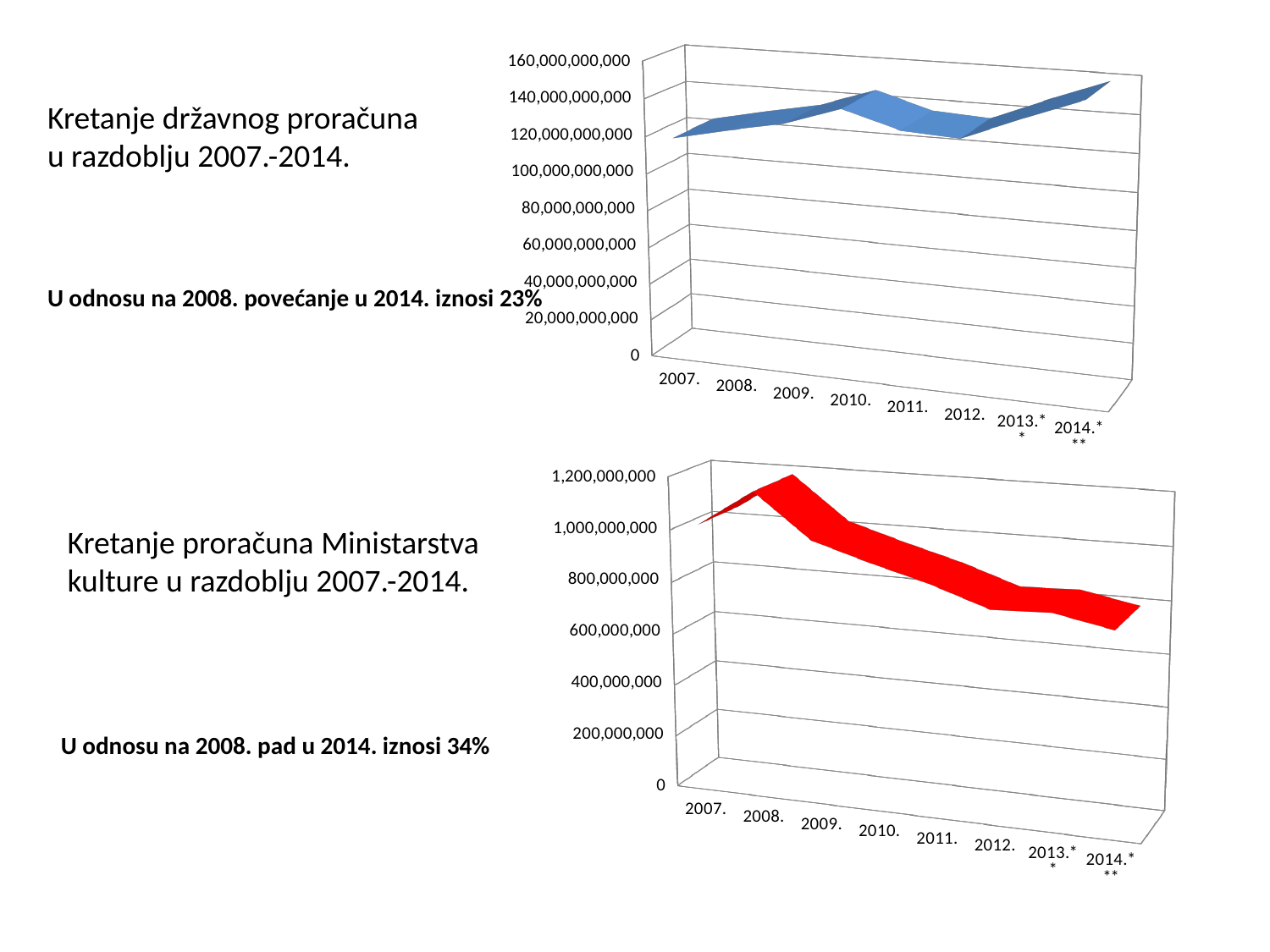
In the bottom chart (Ministry of Culture budget), is the value for 2014. greater or less than 800,000,000? less What colour is the line in the bottom chart (Ministry of Culture budget)? red What kind of chart is the top chart, 'Kretanje državnog proračuna u razdoblju 2007.-2014.'? line chart In the top chart (state budget), which is larger, the value for 2012. or the value for 2014.? 2014. In the bottom chart (Ministry of Culture budget), which year has the lowest value? 2014.*** In the bottom chart (Ministry of Culture budget), is the value for 2008. greater or less than 1,000,000,000? greater What kind of chart is the bottom chart, 'Kretanje proračuna Ministarstva kulture u razdoblju 2007.-2014.'? line chart In the bottom chart (Ministry of Culture budget), do the values rise or fall from 2008. to 2014.? fall In the bottom chart (Ministry of Culture budget), which year has the highest value? 2008. How many years are shown on the x axis of the bottom chart (Ministry of Culture budget)? 8 In the top chart (state budget), is the value for 2007. greater or less than 100,000,000,000? greater How many years are shown on the x axis of the top chart (state budget)? 8